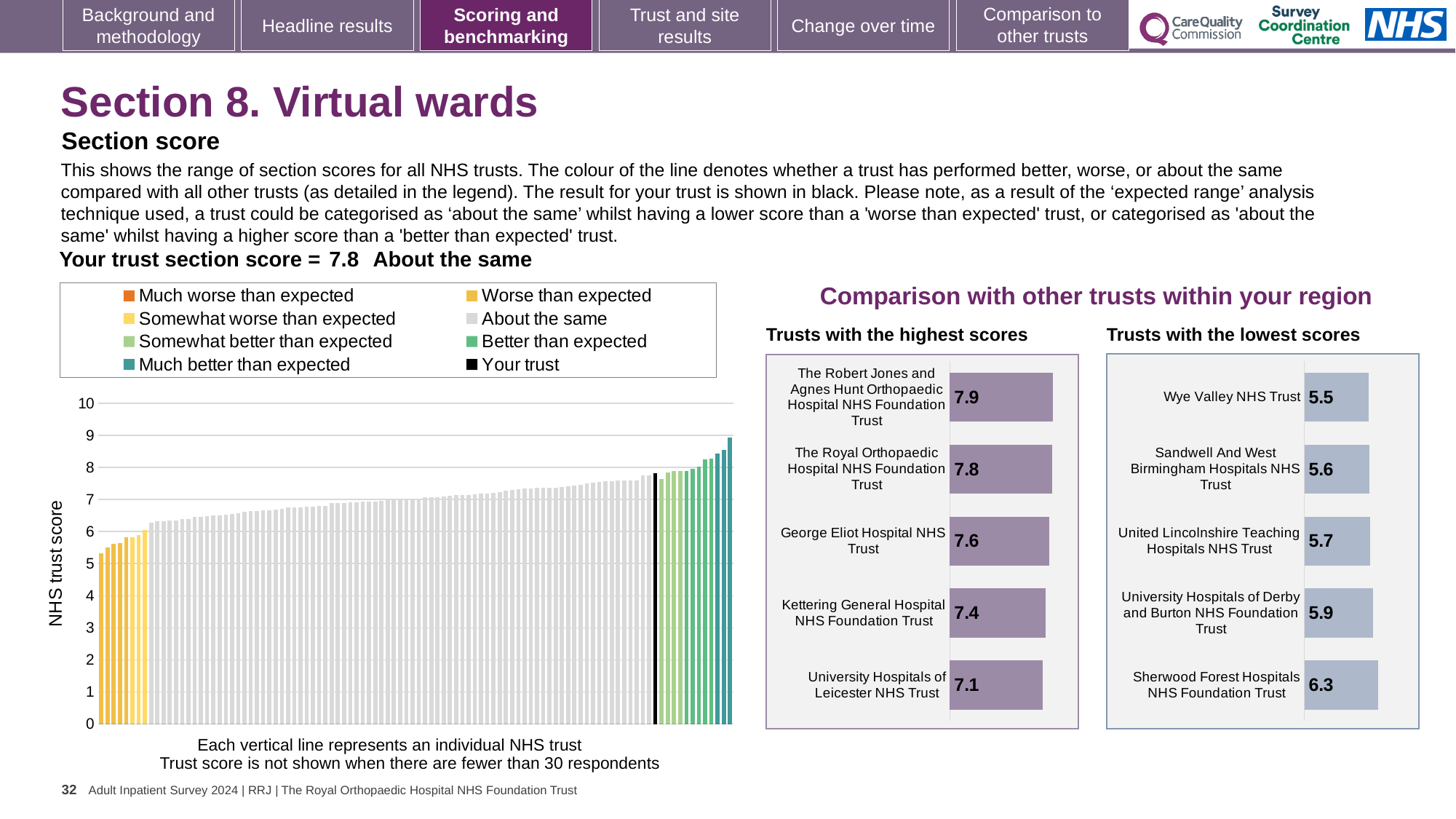
In the 'Trusts with the lowest scores' chart, what is the score for Sherwood Forest Hospitals NHS Foundation Trust? 6.3 What kind of chart is the main NHS trust score chart on the left? bar chart How many trusts are shown in the 'Trusts with the lowest scores' chart? 5 In the 'Trusts with the lowest scores' chart, which trust has the lowest score? Wye Valley NHS Trust In the 'Trusts with the highest scores' chart, what is the difference between the scores of The Robert Jones and Agnes Hunt Orthopaedic Hospital NHS Foundation Trust and University Hospitals of Leicester NHS Trust? 0.8 In the 'Trusts with the highest scores' chart, what is the score for George Eliot Hospital NHS Trust? 7.6 How many entries does the legend of the main NHS trust score chart on the left list? 8 In the 'Trusts with the highest scores' chart, what is the score for Kettering General Hospital NHS Foundation Trust? 7.4 In the 'Trusts with the highest scores' chart, which trust has the highest score? The Robert Jones and Agnes Hunt Orthopaedic Hospital NHS Foundation Trust In the main NHS trust score chart on the left, what is the section score for your trust (the black bar)? 7.8 In the 'Trusts with the lowest scores' chart, which has the larger score: Sandwell And West Birmingham Hospitals NHS Trust or University Hospitals of Derby and Burton NHS Foundation Trust? University Hospitals of Derby and Burton NHS Foundation Trust In the main NHS trust score chart on the left, do the bar values rise or fall from left to right? rise